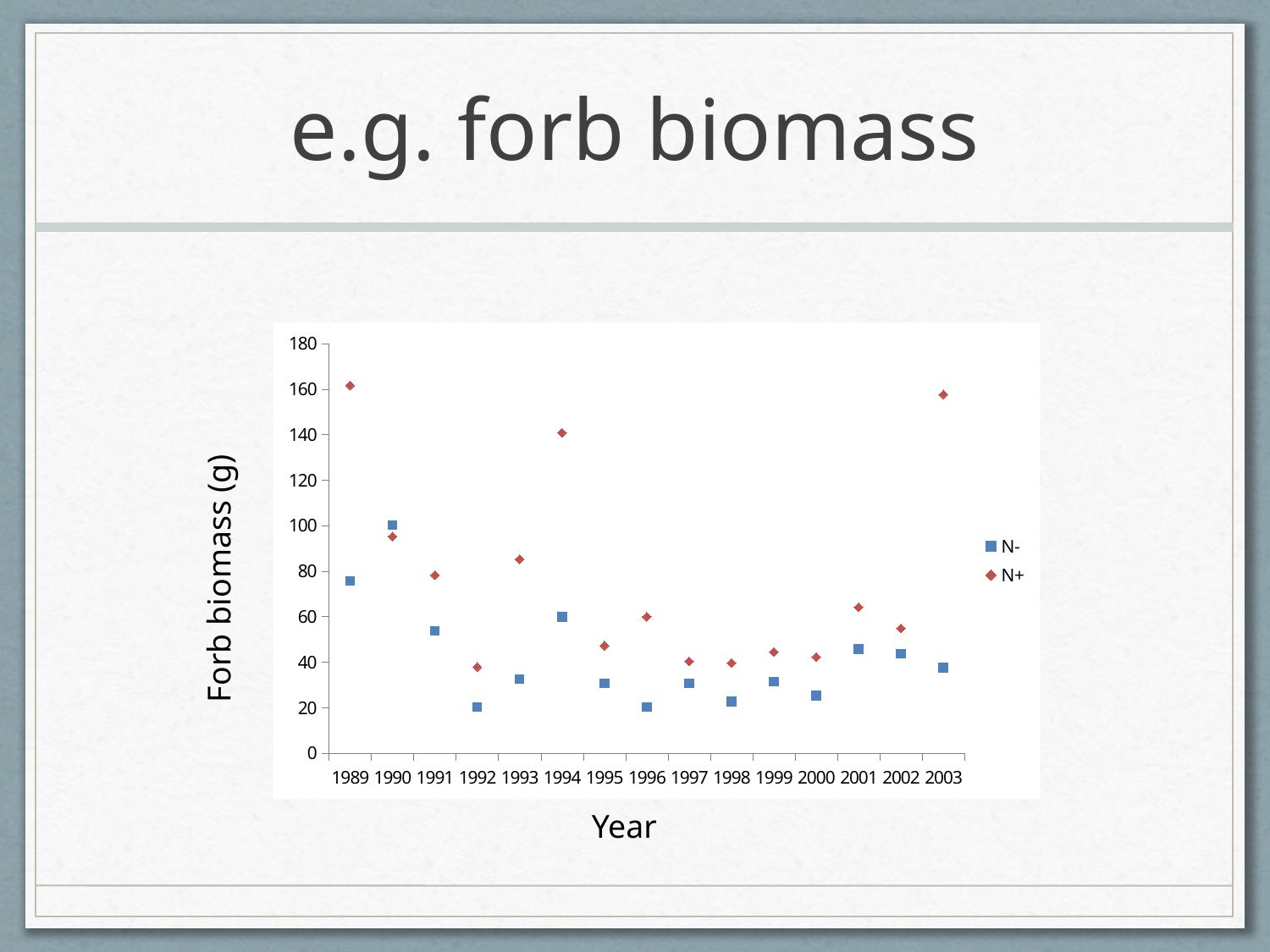
Is the N+ value for 1989 greater or less than 140? greater How many years are plotted along the x axis? 15 In 1989, which series has the larger value, N- or N+? N+ Is the N+ value for 1994 greater or less than 120? greater Which year has the highest N- value? 1990 Which series is plotted with red diamond markers? N+ What is the label on the y axis? Forb biomass (g) In 2001, which series has the larger value, N- or N+? N+ Is the N- value for 2003 greater or less than 60? less What kind of chart is shown on the slide? scatter chart How many series does the legend list? 2